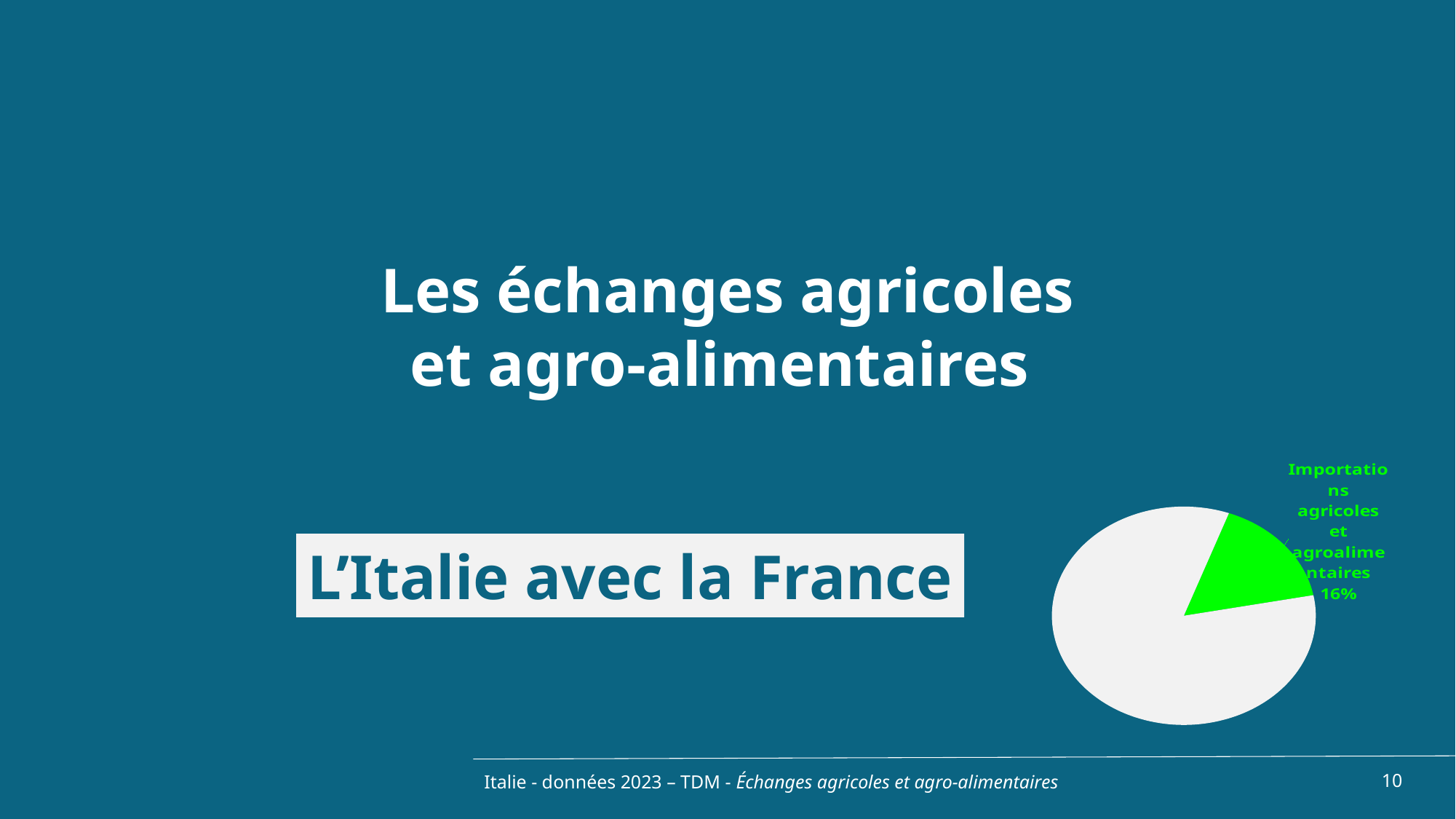
What colour is the slice labelled "Importations agricoles et agroalimentaires"? green What is the data label printed on the green slice of the pie chart? Importations agricoles et agroalimentaires 16% Which slice of the pie chart is the smallest? Importations agricoles et agroalimentaires What share of the pie does the slice labelled "Importations agricoles et agroalimentaires" represent? 16% Which slice of the pie chart is larger, the green slice labelled "Importations agricoles et agroalimentaires" or the unlabelled white slice? the unlabelled white slice What is the label of the only labelled slice in the pie chart? Importations agricoles et agroalimentaires How many slices does the pie chart have? 2 What kind of chart is shown on the slide? pie chart